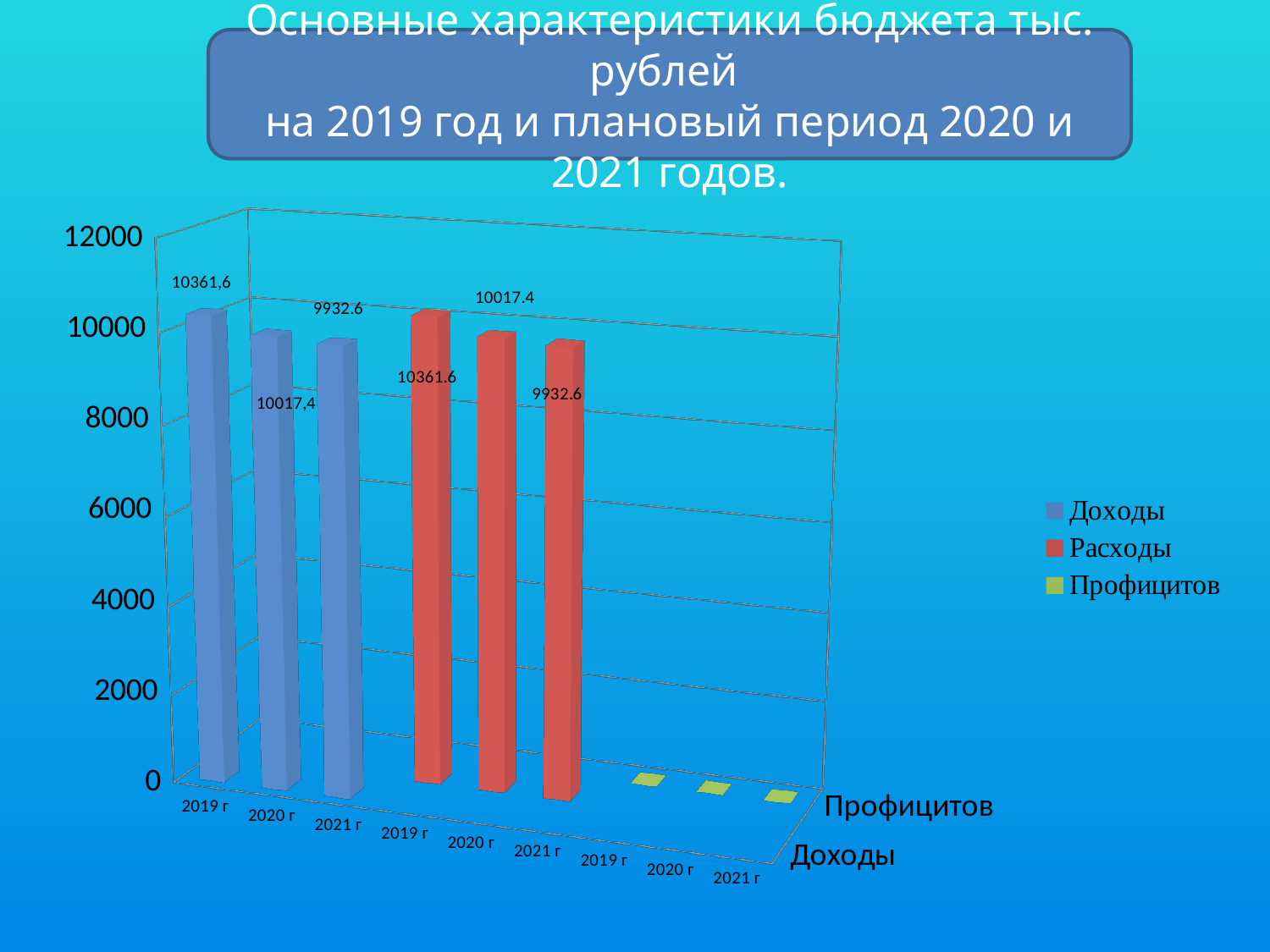
What kind of chart is shown on the slide? bar chart What is the value of Расходы for 2019 г? 10361.6 How many series does the legend list? 3 What is the value of Доходы for 2019 г? 10361,6 Is the value of Доходы for 2020 г greater or less than 8000? greater In which year is Расходы lowest? 2021 г In which year is Доходы highest? 2019 г What is the value of Доходы for 2020 г? 10017,4 Do the Доходы values rise or fall from 2019 г to 2021 г? fall Which is larger: Доходы for 2019 г or Доходы for 2021 г? Доходы for 2019 г What is the value of Расходы for 2021 г? 9932.6 What colour represents the Расходы series in the legend? red